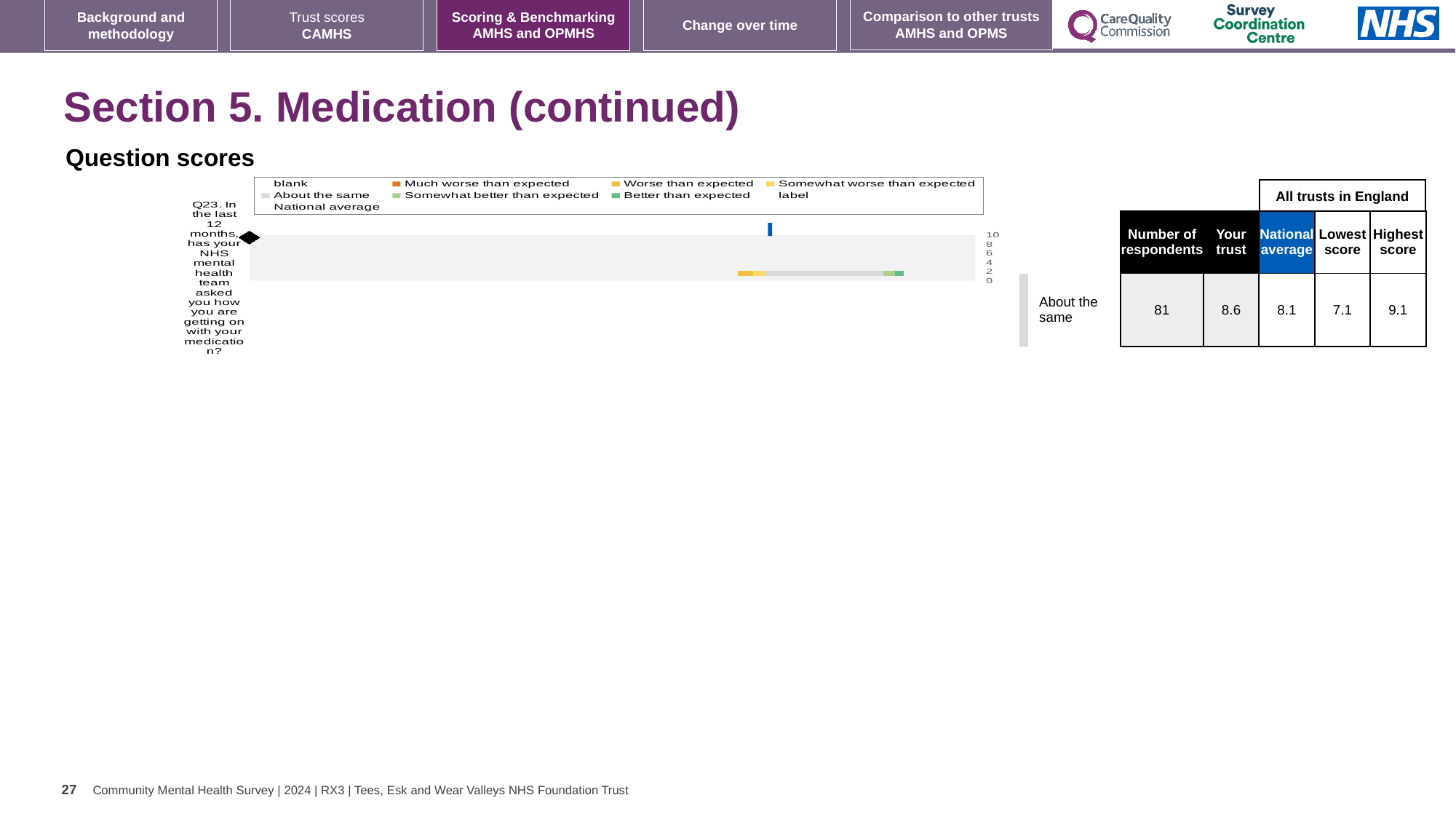
Which question is plotted in the chart? Q23. In the last 12 months, has your NHS mental health team asked you how you are getting on with your medication? What is the highest score among all trusts in England for Q23? 9.1 Which benchmark category is the trust's Q23 score placed in? About the same What is the national average score for Q23? 8.1 What is the difference between the 'Your trust' score and the national average for Q23? 0.5 How many respondents answered Q23? 81 What is the difference between the highest and lowest scores for Q23? 2.0 What is the 'Your trust' score for Q23? 8.6 Which is larger for Q23, the 'Your trust' score or the national average? Your trust What kind of chart is shown under 'Question scores'? bar chart What is the lowest score among all trusts in England for Q23? 7.1 How many survey questions are plotted in the chart? 1